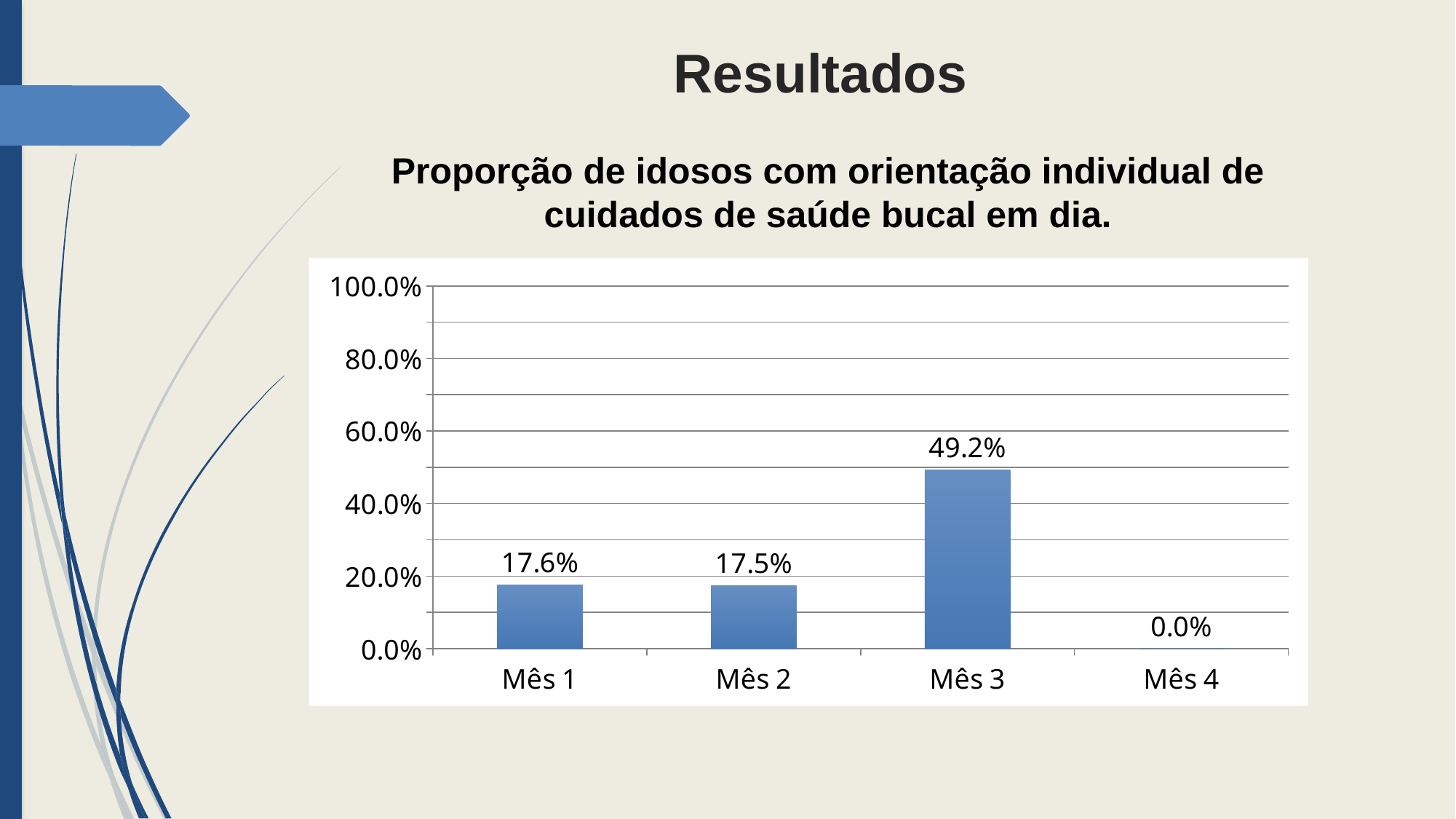
What is the title of the chart? Proporção de idosos com orientação individual de cuidados de saúde bucal em dia. What is the value for Mês 2? 17.5% Which month has the lowest value? Mês 4 What kind of chart is shown on the slide? bar chart How many months are shown on the x axis? 4 Which month has the highest value? Mês 3 Which is larger, the value for Mês 3 or the value for Mês 2? Mês 3 Is the value for Mês 3 greater or less than 40.0%? greater What is the value for Mês 3? 49.2% What is the value for Mês 1? 17.6% What is the value for Mês 4? 0.0% What is the difference between the values for Mês 3 and Mês 1? 31.6%